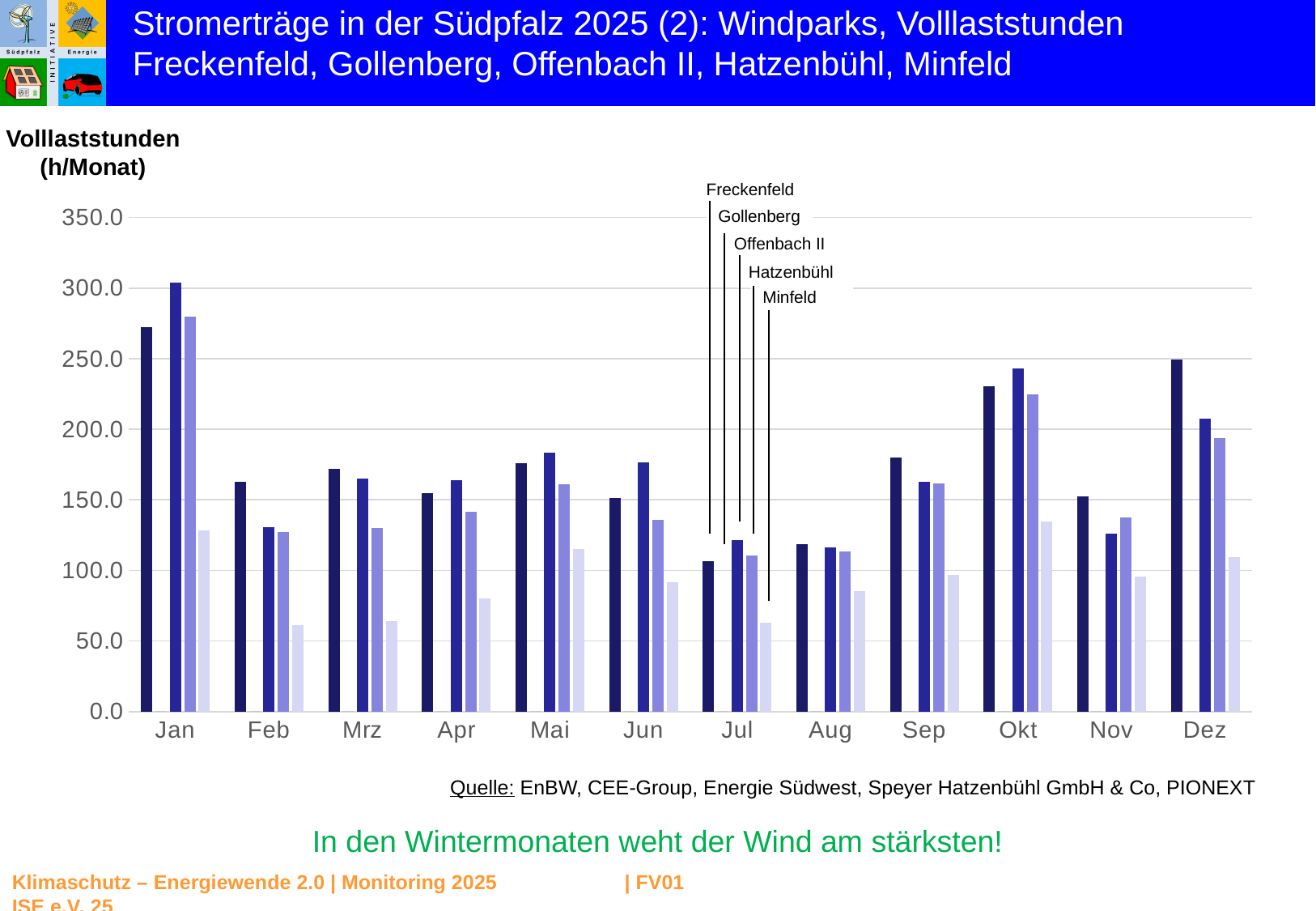
Is the tallest bar in Dez greater or less than 200? greater Is the tallest bar in Jul greater or less than 150? less Which wind parks are listed in the chart's legend? Freckenfeld, Gollenberg, Offenbach II, Hatzenbühl, Minfeld In which month does the chart reach its tallest bar? Jan How many months are shown on the x axis of the chart? 12 What kind of chart is shown on the slide? bar chart How many wind parks (series) does the chart's legend list? 5 Is the tallest bar in Jan greater or less than 250? greater What is the unit given for the y axis of the chart? h/Monat Do the full-load hours generally rise or fall from Jan to Jul? fall Which month has the taller maximum bar, Jan or Dez? Jan